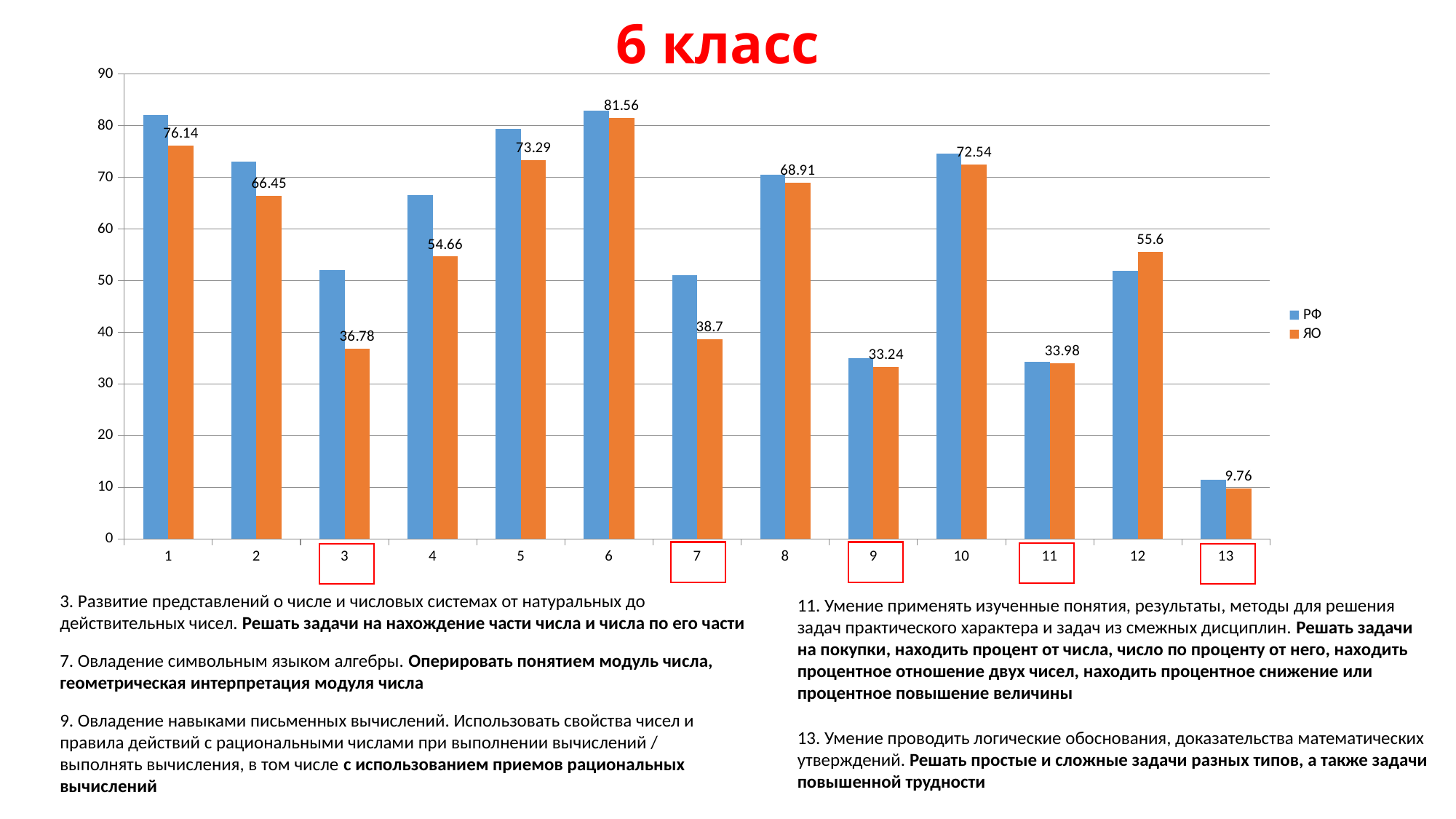
Which category has the lowest ЯО value? 13 In category 12, which series has the larger value, РФ or ЯО? ЯО What is the value for ЯО in category 6? 81.56 What is the value for ЯО in category 13? 9.76 In category 3, which series has the larger value, РФ or ЯО? РФ Which category has the highest ЯО value? 6 What is the value for ЯО in category 3? 36.78 What is the title of the slide above the chart? 6 класс What is the difference between the ЯО values for category 1 and category 2? 9.69 How many categories are shown on the x axis? 13 Is the РФ value for category 1 greater or less than 80? greater How many series does the legend list? 2